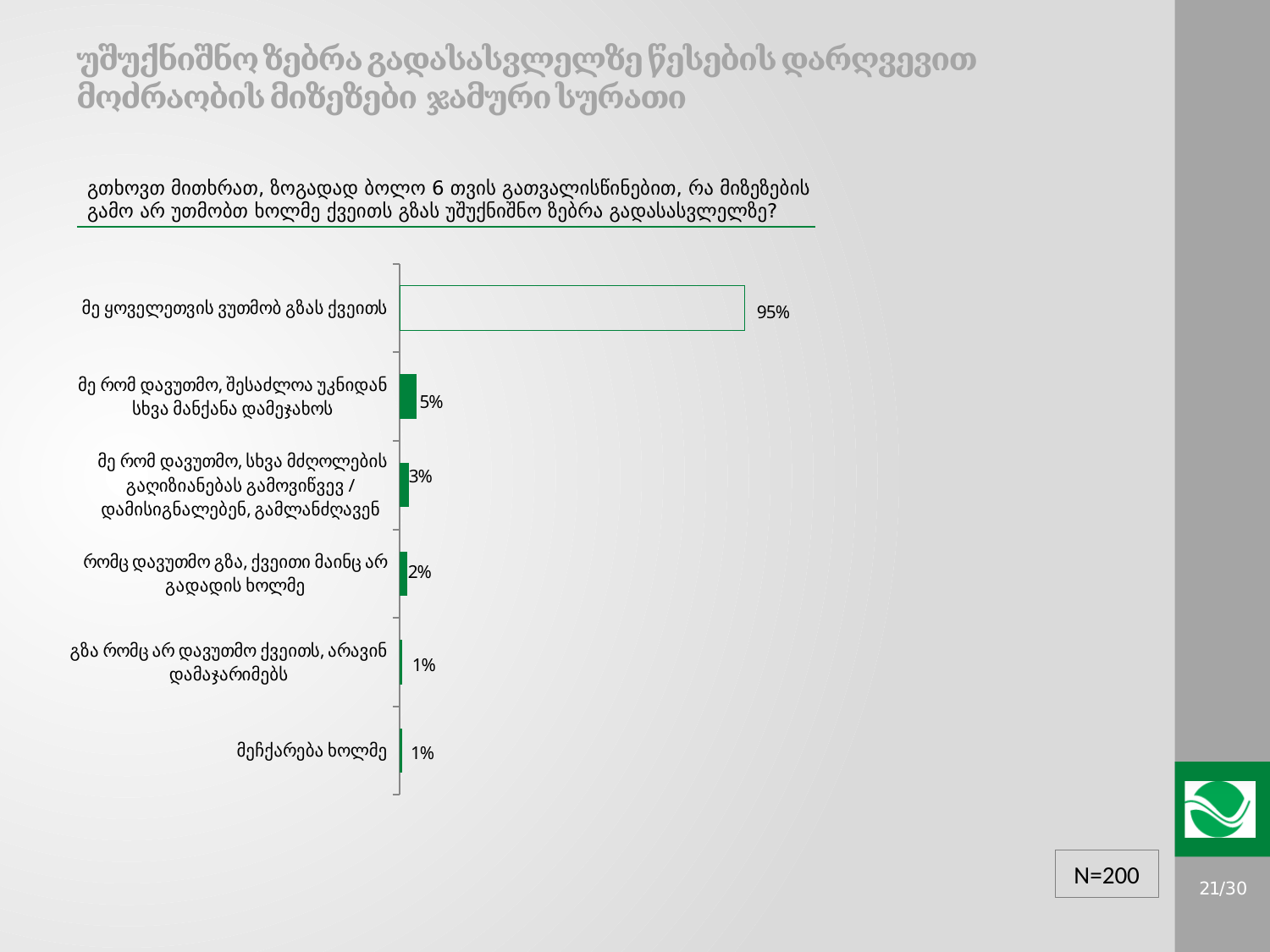
What kind of chart is shown on the slide? bar chart What is the value for "მეჩქარება ხოლმე"? 1% What is the lowest value shown in the chart? 1% What sample size (N) is shown on the slide? N=200 What is the value for "მე ყოველთვის ვუთმობ გზას ქვეითს"? 95% Which is larger: the value for "მე რომ დავუთმო, შესაძლოა უკნიდან სხვა მანქანა დამეჯახოს" or the value for "რომც დავუთმო გზა, ქვეითი მაინც არ გადადის ხოლმე"? მე რომ დავუთმო, შესაძლოა უკნიდან სხვა მანქანა დამეჯახოს What is the value for "მე რომ დავუთმო, სხვა მძღოლების გაღიზიანებას გამოვიწვევ / დამისიგნალებენ, გამლანძღავენ"? 3% What is the value for "მე რომ დავუთმო, შესაძლოა უკნიდან სხვა მანქანა დამეჯახოს"? 5% How many categories (bars) does the chart show? 6 What is the value for "რომც დავუთმო გზა, ქვეითი მაინც არ გადადის ხოლმე"? 2% What is the difference between the value for "მე ყოველთვის ვუთმობ გზას ქვეითს" and the value for "მე რომ დავუთმო, შესაძლოა უკნიდან სხვა მანქანა დამეჯახოს"? 90% Which category has the highest value? მე ყოველთვის ვუთმობ გზას ქვეითს